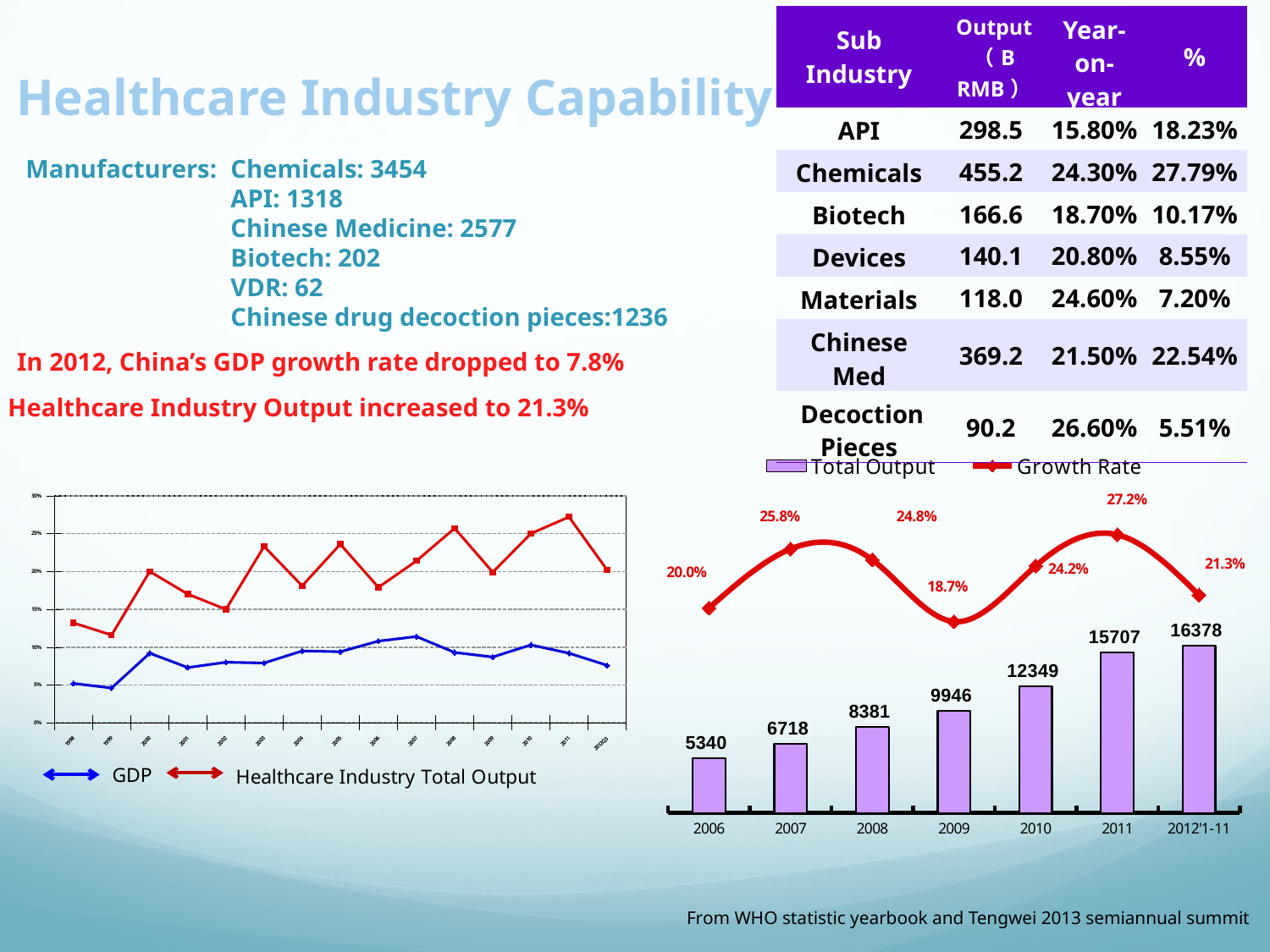
In the bottom-right chart, what is the difference in Total Output between 2011 and 2010? 3358 In the bottom-right chart, which is larger, the Growth Rate for 2007 or for 2008? 2007 In the bottom-right chart, which year has the highest Total Output? 2012'1-11 What kind of chart is the bottom-left chart? line chart In the bottom-right chart, does the Total Output rise or fall from 2006 to 2012'1-11? rise In the bottom-right chart, how many series does the legend list? 2 In the bottom-right chart, what is the Growth Rate for 2006? 20.0% In the bottom-right chart, which year has the lowest Growth Rate? 2009 In the bottom-right chart, what is the Growth Rate for 2011? 27.2% In the bottom-right chart, what is the Total Output value for 2009? 9946 In the bottom-left chart, what are the two series listed in the legend? GDP and Healthcare Industry Total Output In the bottom-right chart, how many years are shown on the x axis? 7